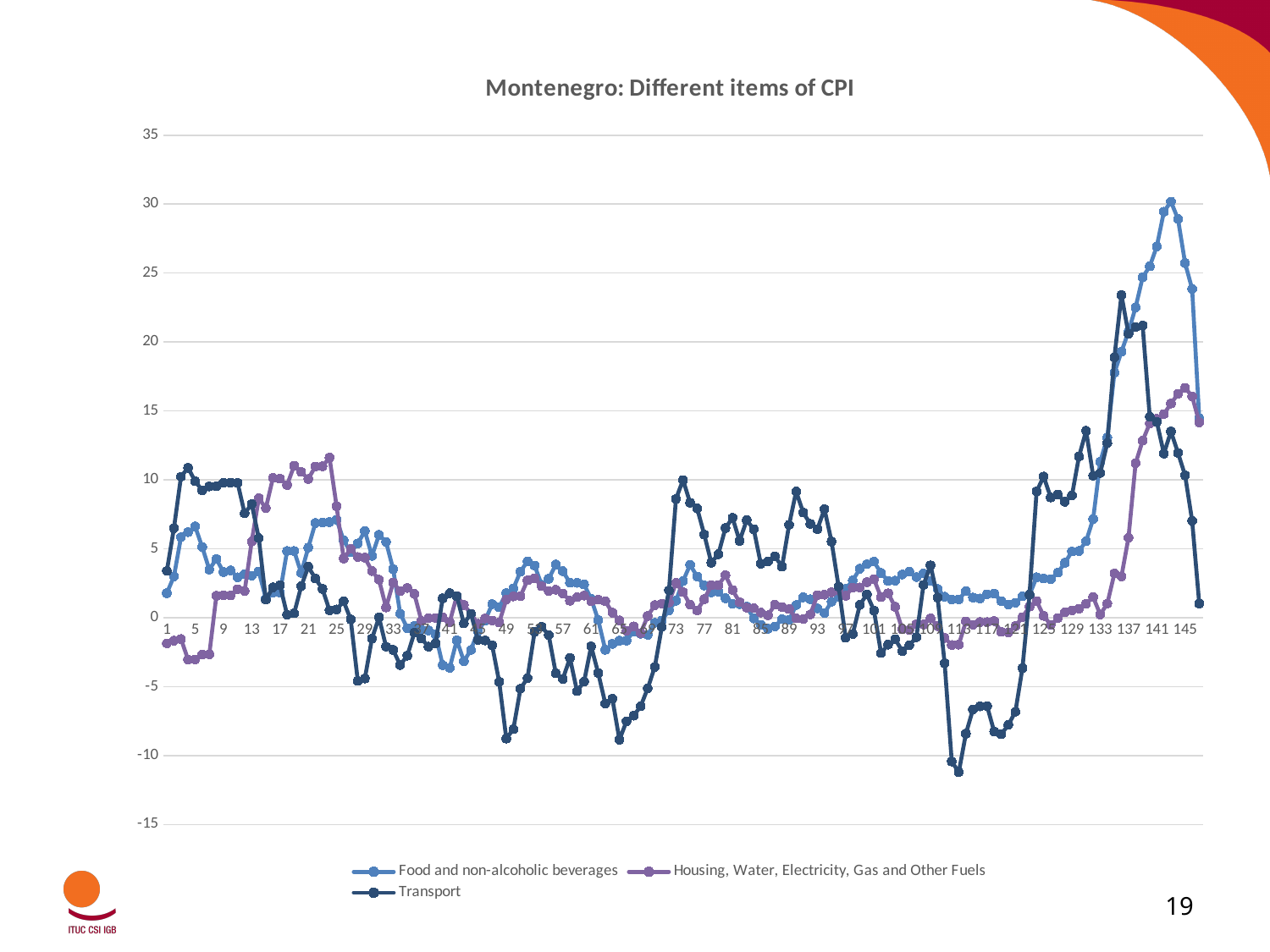
Is the lowest value of the Transport series greater or less than -5? less Between x = 129 and x = 141, does the Food and non-alcoholic beverages series rise or fall? rise What is the highest value shown on the vertical axis? 35 At x = 145, which is larger: Food and non-alcoholic beverages or Housing, Water, Electricity, Gas and Other Fuels? Food and non-alcoholic beverages What type of chart is shown on the slide? Line chart Is the peak value of the Housing, Water, Electricity, Gas and Other Fuels series greater or less than 10? greater What is the title of the chart? Montenegro: Different items of CPI Which series reaches the highest value on the chart? Food and non-alcoholic beverages Is the peak value of the Food and non-alcoholic beverages series greater or less than 25? greater How many series does the legend list? 3 Which series reaches the lowest value on the chart? Transport